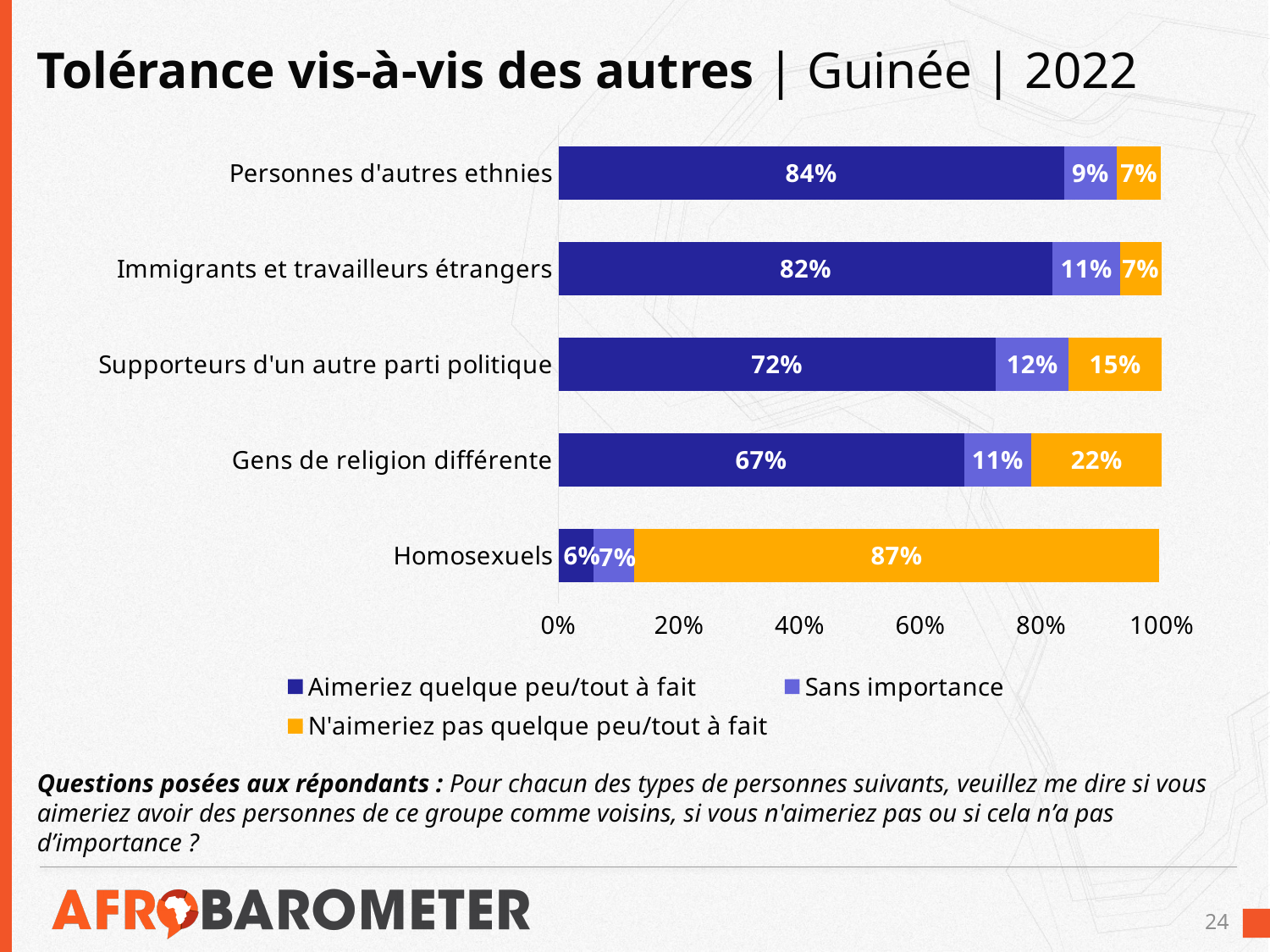
What type of chart is shown on the slide? Stacked bar chart What is the 'N'aimeriez pas quelque peu/tout à fait' value for Homosexuels? 87% What percentage of respondents would like (somewhat/strongly) to have people of other ethnicities as neighbours? 84% What is the difference between the 'Aimeriez quelque peu/tout à fait' values for Personnes d'autres ethnies and Gens de religion différente? 17 percentage points What is the 'Sans importance' value for Supporteurs d'un autre parti politique? 12% How many series does the legend list? 3 What is the total of the three segments for Immigrants et travailleurs étrangers? 100% What is the 'N'aimeriez pas quelque peu/tout à fait' value for Gens de religion différente? 22% Which is larger: the 'N'aimeriez pas' value for Supporteurs d'un autre parti politique or for Gens de religion différente? Gens de religion différente Which category has the lowest 'Aimeriez quelque peu/tout à fait' value? Homosexuels Which category has the highest 'Aimeriez quelque peu/tout à fait' value? Personnes d'autres ethnies How many categories (groups of people) are shown in the chart? 5